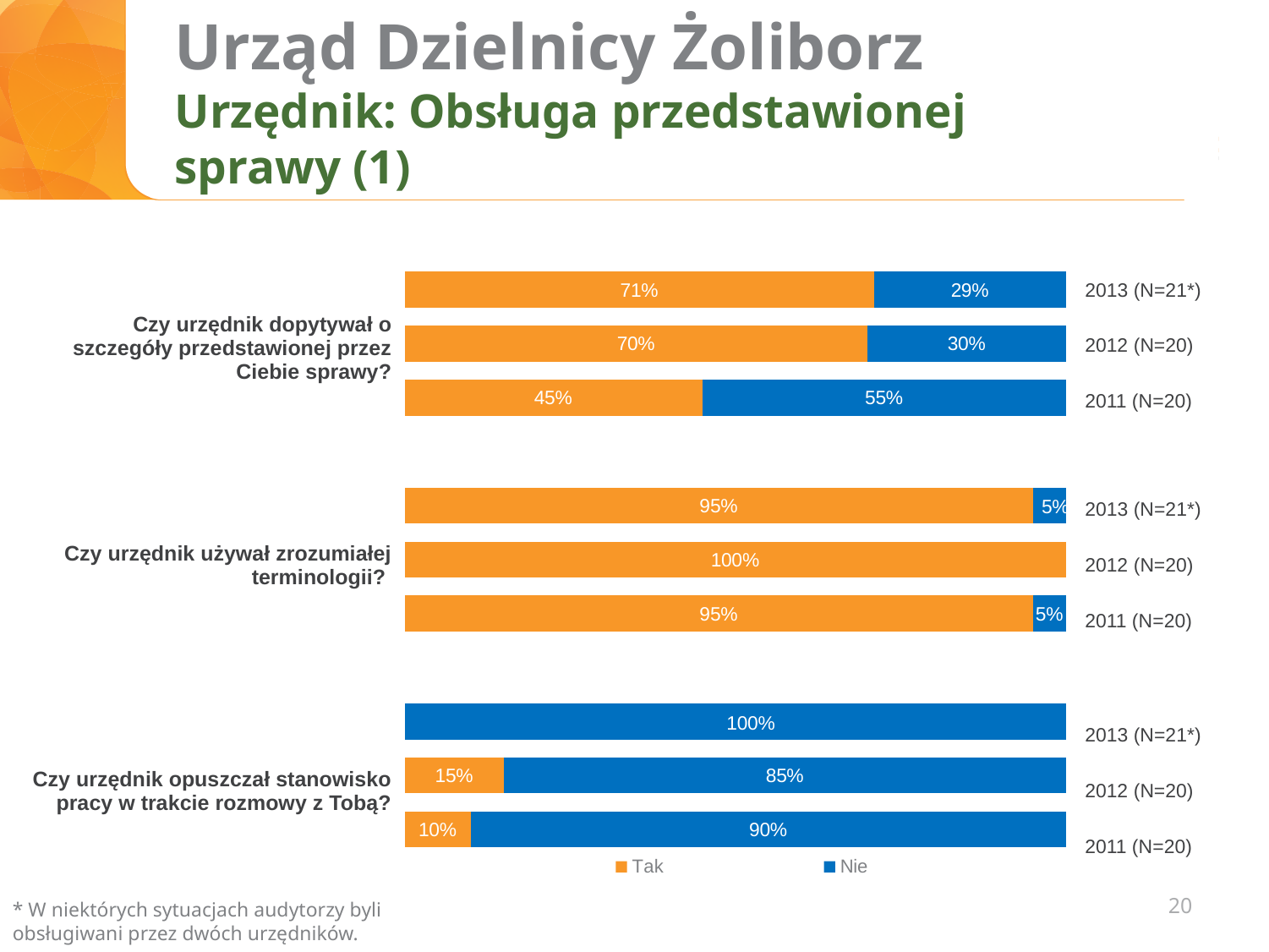
What is the 'Nie' value for 2011 (N=20) for the question 'Czy urzędnik dopytywał o szczegóły przedstawionej przez Ciebie sprawy?'? 55% For the question 'Czy urzędnik opuszczał stanowisko pracy w trakcie rozmowy z Tobą?', is the 'Nie' value larger in 2011 (N=20) or in 2012 (N=20)? 2011 (N=20) How many series does the legend list? 2 For the question 'Czy urzędnik opuszczał stanowisko pracy w trakcie rozmowy z Tobą?', which year has the highest 'Tak' value? 2012 (N=20) What is the 'Tak' value for 2012 (N=20) for the question 'Czy urzędnik używał zrozumiałej terminologii?'? 100% What is the 'Nie' value for 2013 (N=21*) for the question 'Czy urzędnik opuszczał stanowisko pracy w trakcie rozmowy z Tobą?'? 100% How many bars are plotted on the chart in total? 9 For the question 'Czy urzędnik dopytywał o szczegóły przedstawionej przez Ciebie sprawy?', what is the difference between the 'Tak' values for 2013 (N=21*) and 2011 (N=20)? 26% For the question 'Czy urzędnik dopytywał o szczegóły przedstawionej przez Ciebie sprawy?', which year has the lowest 'Tak' value? 2011 (N=20) What kind of chart is shown on the slide? stacked bar chart What are the two series named in the legend? Tak and Nie What is the 'Tak' value for 2013 (N=21*) for the question 'Czy urzędnik dopytywał o szczegóły przedstawionej przez Ciebie sprawy?'? 71%